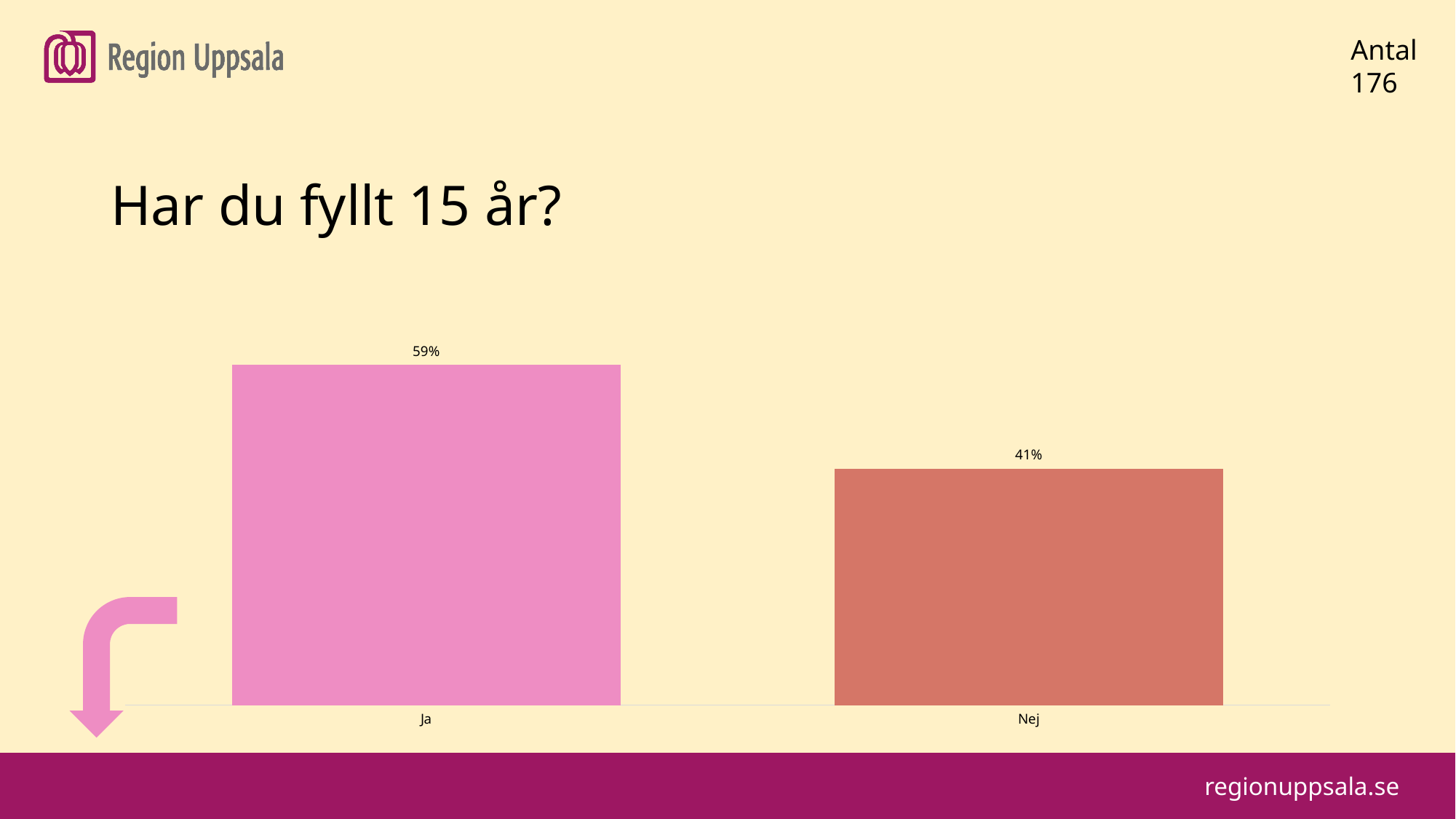
Which category has the highest value? Ja What is the total of the values for Ja and Nej? 100% What is the number of respondents (Antal) shown on the slide? 176 Which category has the lowest value? Nej What kind of chart is shown on the slide? bar chart What is the value for Ja? 59% Which is larger, the value for Ja or the value for Nej? Ja What is the value for Nej? 41% What is the difference between the values for Ja and Nej? 18% What question is the chart on the slide about? Har du fyllt 15 år? How many categories are shown in the chart? 2